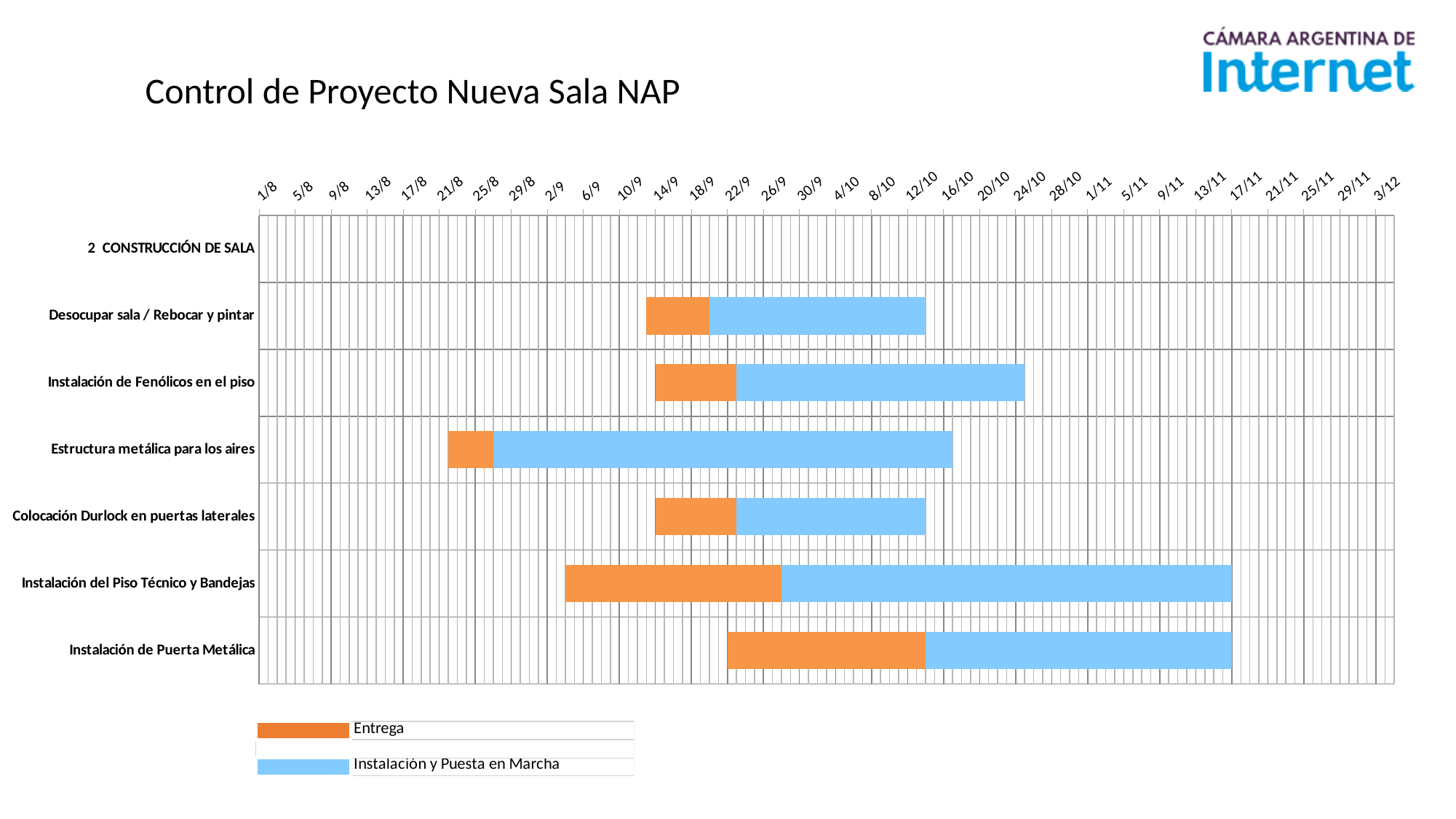
Does Instalación del Piso Técnico y Bandejas end before or after 1/11? after What are the two legend entries? Entrega; Instalación y Puesta en Marcha How many series does the legend list? 2 How many tasks have bars plotted in the chart? 6 Which task starts earliest on the timeline? Estructura metálica para los aires What kind of chart is shown on the slide? Bar chart (Gantt chart) Does Estructura metálica para los aires start before or after Desocupar sala / Rebocar y pintar? before Which task starts latest on the timeline? Instalación de Puerta Metálica What is the first date label on the x axis? 1/8 Which task has the shortest Entrega (orange) segment? Estructura metálica para los aires What is the title of the chart? Control de Proyecto Nueva Sala NAP Does Instalación de Puerta Metálica start before or after 1/10? before